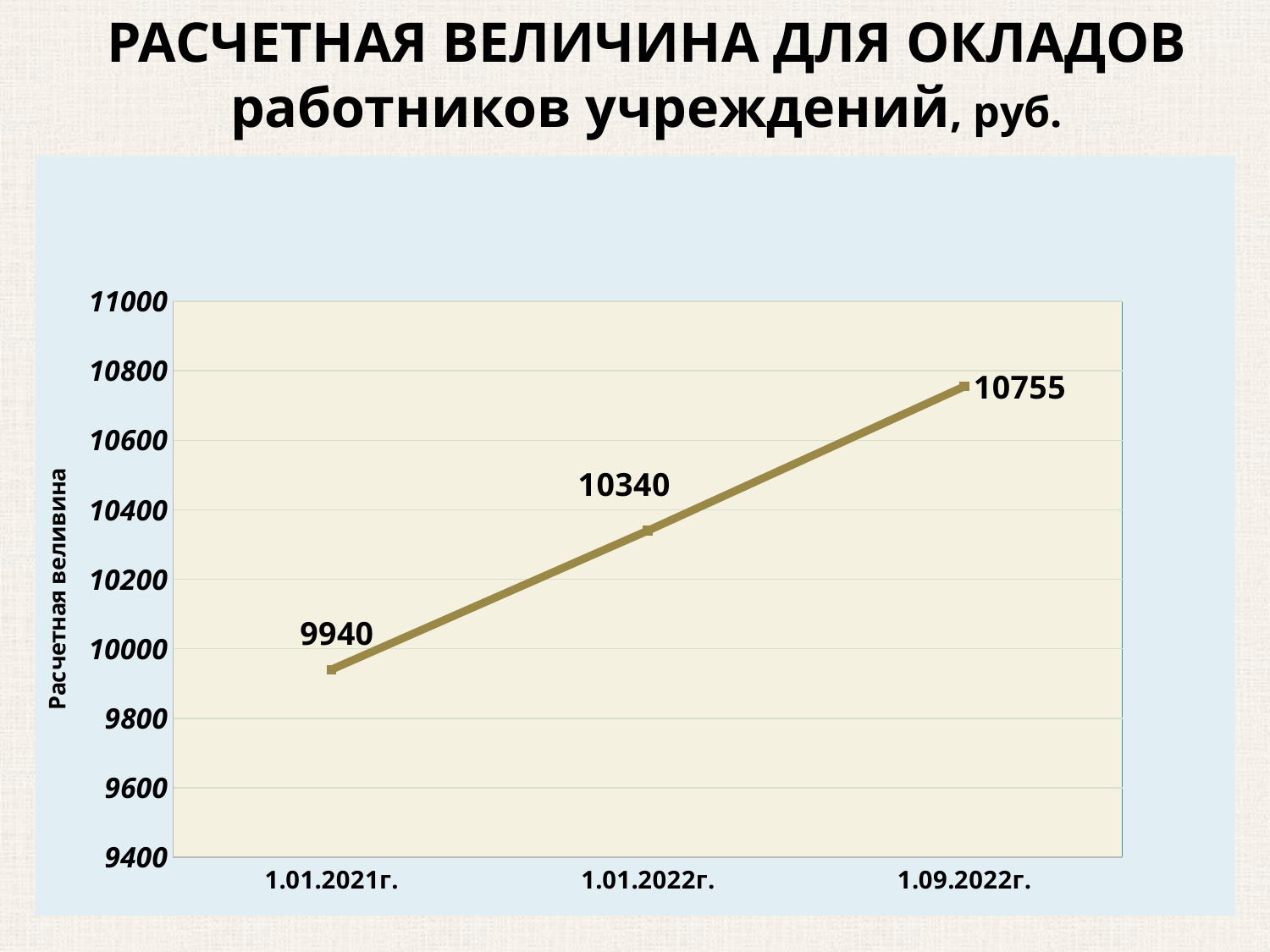
What is the value for 1.09.2022г.? 10755 Which date has the lowest value? 1.01.2021г. Is the value for 1.09.2022г. greater or less than 10600? greater How many data points are plotted on the chart? 3 What is the value for 1.01.2022г.? 10340 What is the difference between the values for 1.01.2022г. and 1.01.2021г.? 400 What kind of chart is shown on the slide? line chart What is the difference between the values for 1.09.2022г. and 1.01.2021г.? 815 Do the values rise or fall from 1.01.2021г. to 1.09.2022г.? rise Which date has the highest value? 1.09.2022г. What is the value for 1.01.2021г.? 9940 Which is larger, the value for 1.01.2022г. or the value for 1.01.2021г.? 1.01.2022г.